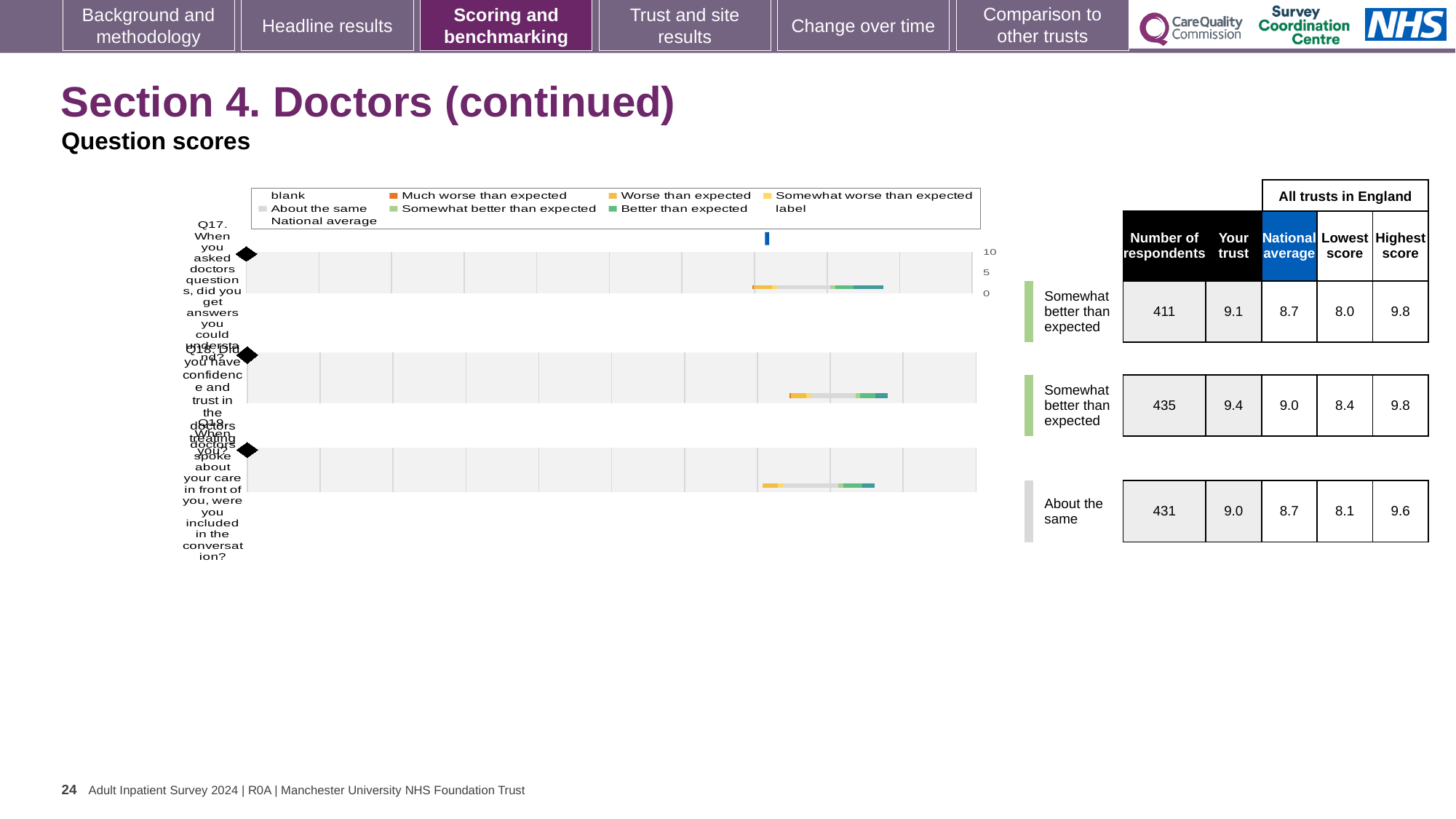
Which question has the highest 'Your trust' score? Q18 What kind of chart is shown on the slide? bar chart How many questions (categories) are plotted in the chart? 3 How many respondents answered Q19 (being included in the conversation when doctors spoke about your care)? 431 What is the difference between the 'Your trust' score and the national average for Q18? 0.4 What is the highest score among all trusts in England for Q19? 9.6 Which is larger, the 'Your trust' score for Q17 or for Q19? Q17 What is the national average score for Q17 (getting answers you could understand from doctors)? 8.7 What is the 'Your trust' score for Q18 (confidence and trust in the doctors treating you)? 9.4 What benchmark category is shown for Q19? About the same Which question has the lowest 'Your trust' score? Q19 How many entries does the chart legend list? 9